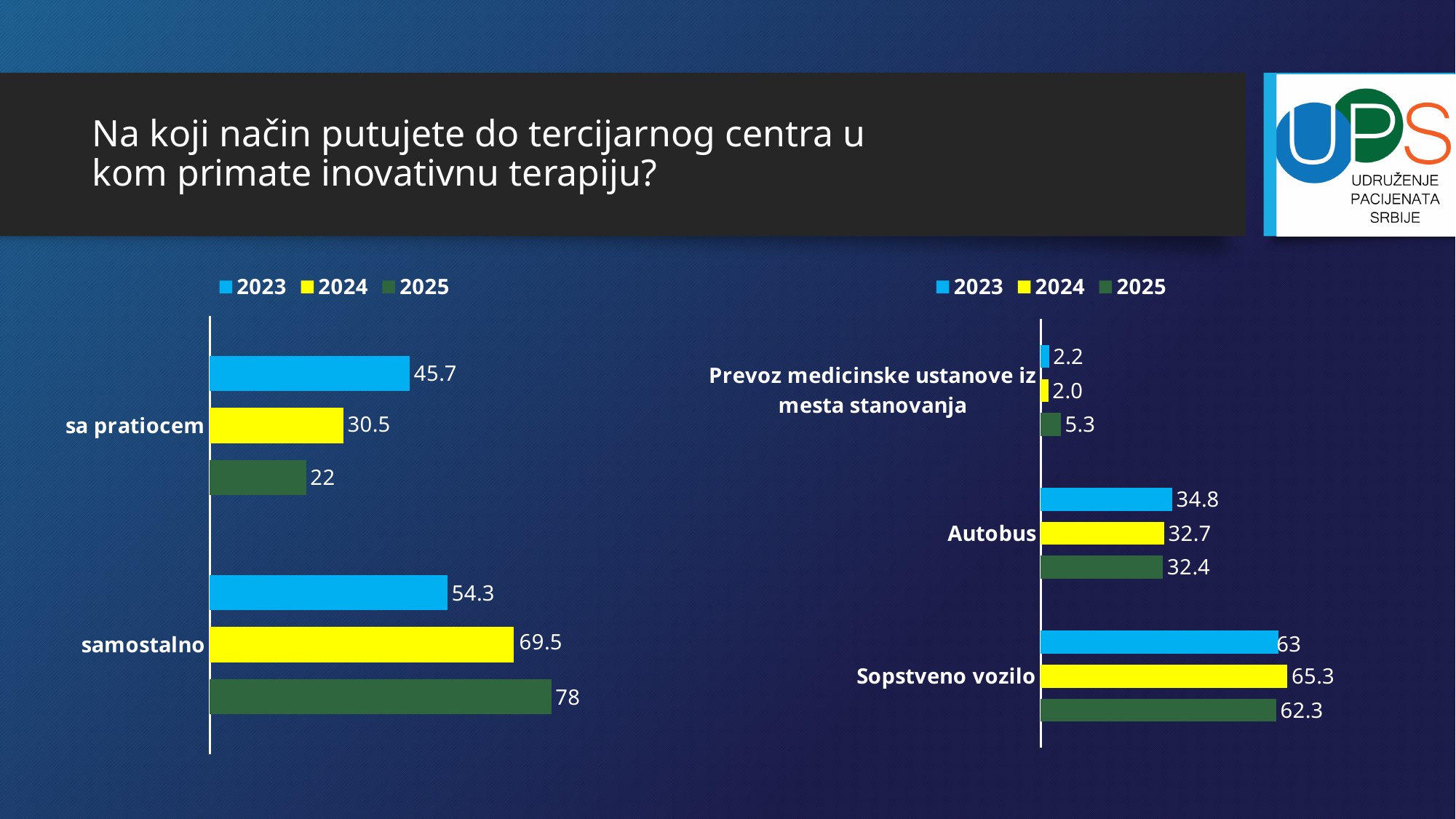
In the right chart, what is the 2025 value for 'Prevoz medicinske ustanove iz mesta stanovanja'? 5.3 In the right chart, which category has the highest 2023 value? Sopstveno vozilo What type of chart is the left chart? Bar chart In the right chart, what is the difference between the 2024 and 2025 values for 'Sopstveno vozilo'? 3 In the right chart, what is the 2024 value for 'Autobus'? 32.7 How many series does the legend of the left chart list? 3 How many categories does the right chart show? 3 In the left chart, what is the 2023 value for 'sa pratiocem'? 45.7 In the left chart, what is the 2025 value for 'samostalno'? 78 In the right chart, which category has the lowest 2024 value? Prevoz medicinske ustanove iz mesta stanovanja In the left chart, which is larger for 'sa pratiocem': the 2024 value or the 2025 value? 2024 In the left chart, what is the difference between the 2025 and 2023 values for 'samostalno'? 23.7